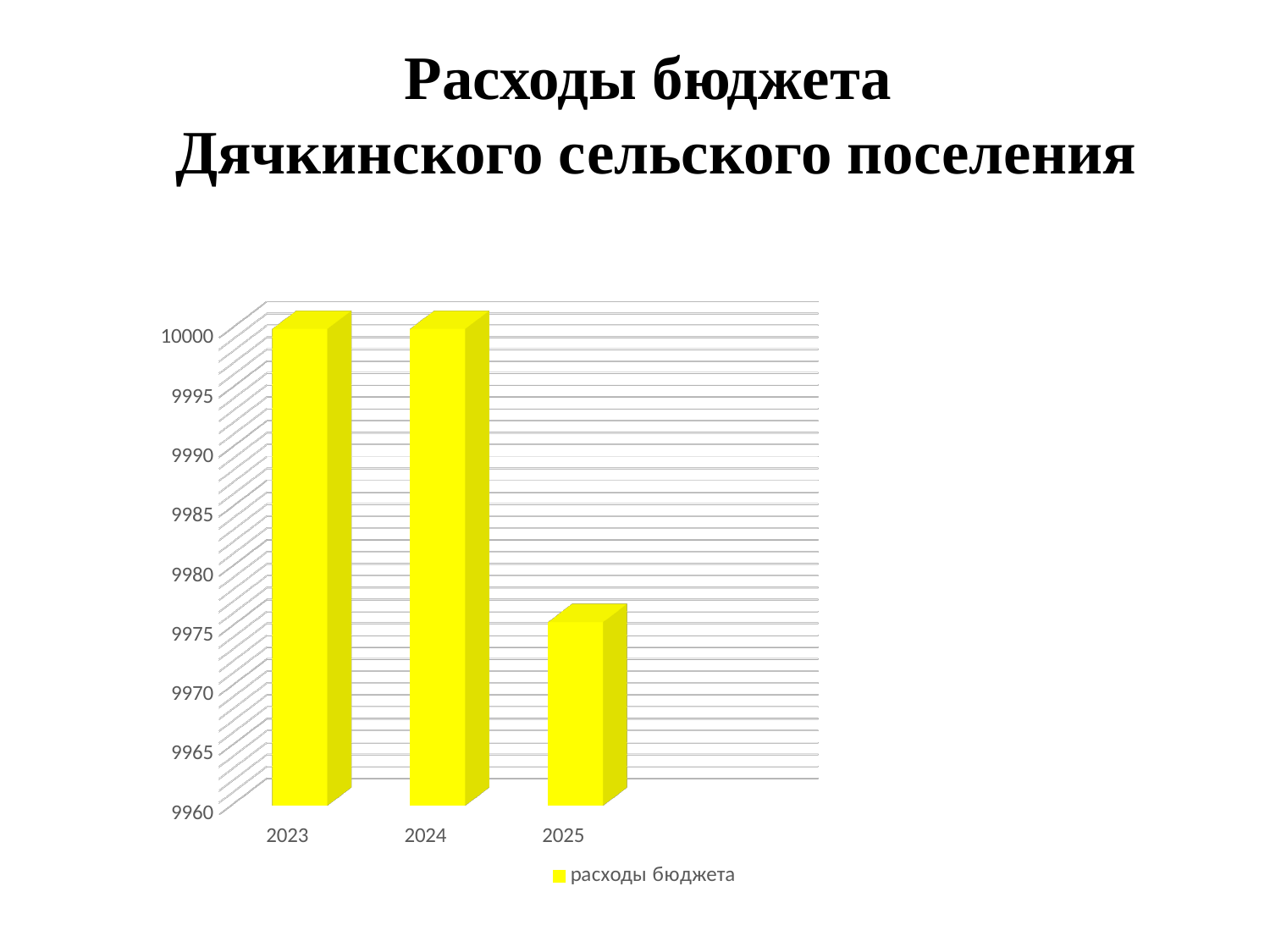
Which is larger, the value for 2023 or the value for 2025? 2023 Which is larger, the value for 2024 or the value for 2025? 2024 Which year has the lowest value in the chart? 2025 Is the value for 2023 greater or less than 9990? greater What is the name of the series shown in the chart legend? расходы бюджета Is the value for 2025 greater or less than 9970? greater Do the values rise or fall from 2023 to 2025? fall What colour are the bars in the chart? yellow What kind of chart is shown on the slide? bar chart How many years are shown on the x axis of the chart? 3 How many series does the chart legend list? 1 Is the value for 2025 greater or less than 9980? less